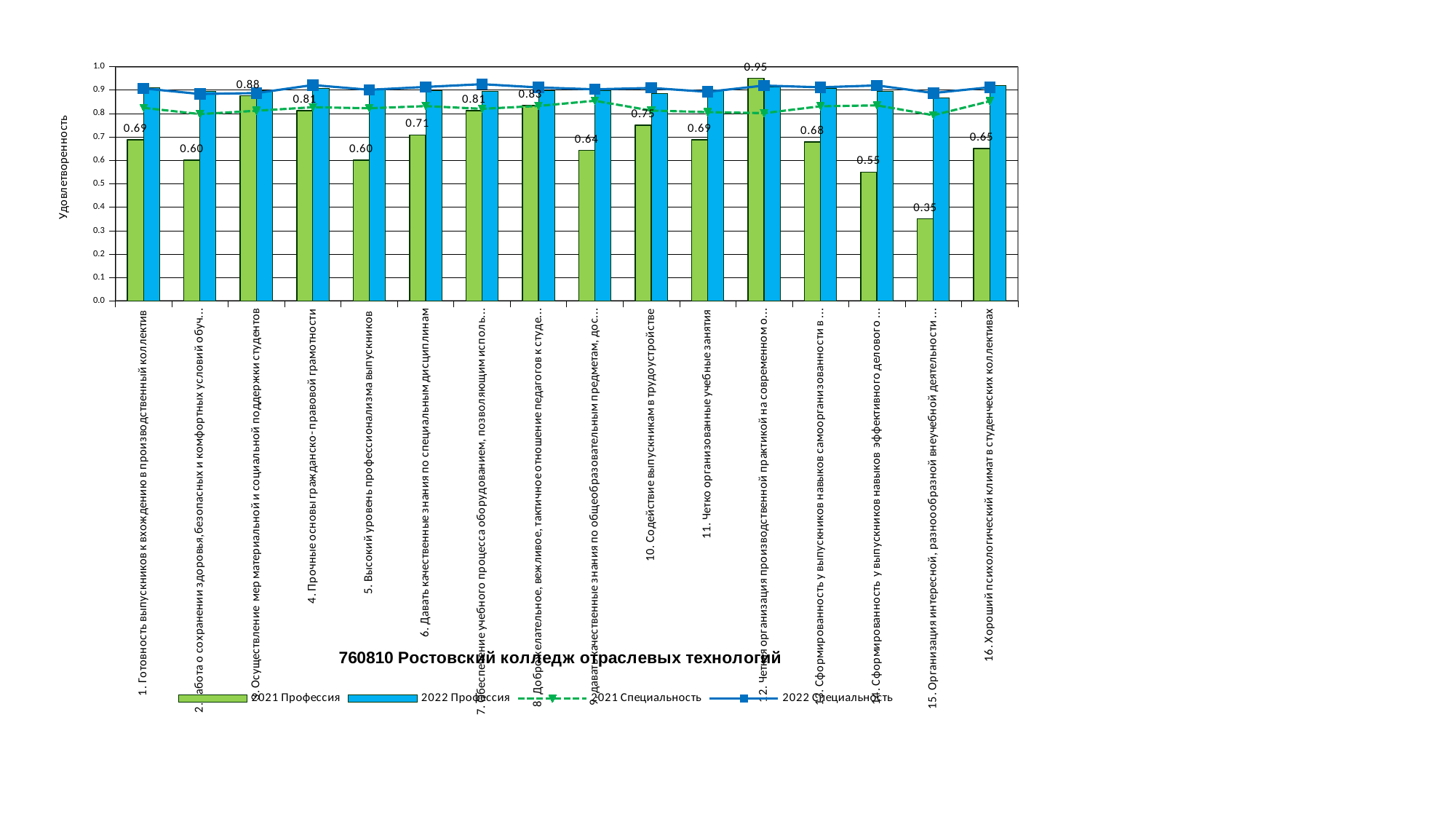
What is the lowest value shown among the 2021 Профессия bars? 0.35 Is the 2022 Профессия value for "1. Готовность выпускников к вхождению в производственный коллектив" greater or less than 0.8? greater What is the title of the chart? 760810 Ростовский колледж отраслевых технологий What is the 2021 Профессия value for "4. Прочные основы гражданско-правовой грамотности"? 0.81 How many categories are shown on the x axis of the chart? 16 What kind of chart is shown on the slide? Combined bar and line chart What is the 2021 Профессия value for "16. Хороший психологический климат в студенческих коллективах"? 0.65 Which has the larger 2021 Профессия value: "10. Содействие выпускникам в трудоустройстве" or "6. Давать качественные знания по специальным дисциплинам"? 10. Содействие выпускникам в трудоустройстве What is the difference between the 2021 Профессия values for category 4 (Прочные основы гражданско-правовой грамотности) and category 5 (Высокий уровень профессионализма выпускников)? 0.21 What is the 2021 Профессия value for "5. Высокий уровень профессионализма выпускников"? 0.60 How many series does the legend list? 4 What is the highest value shown among the 2021 Профессия bars? 0.95